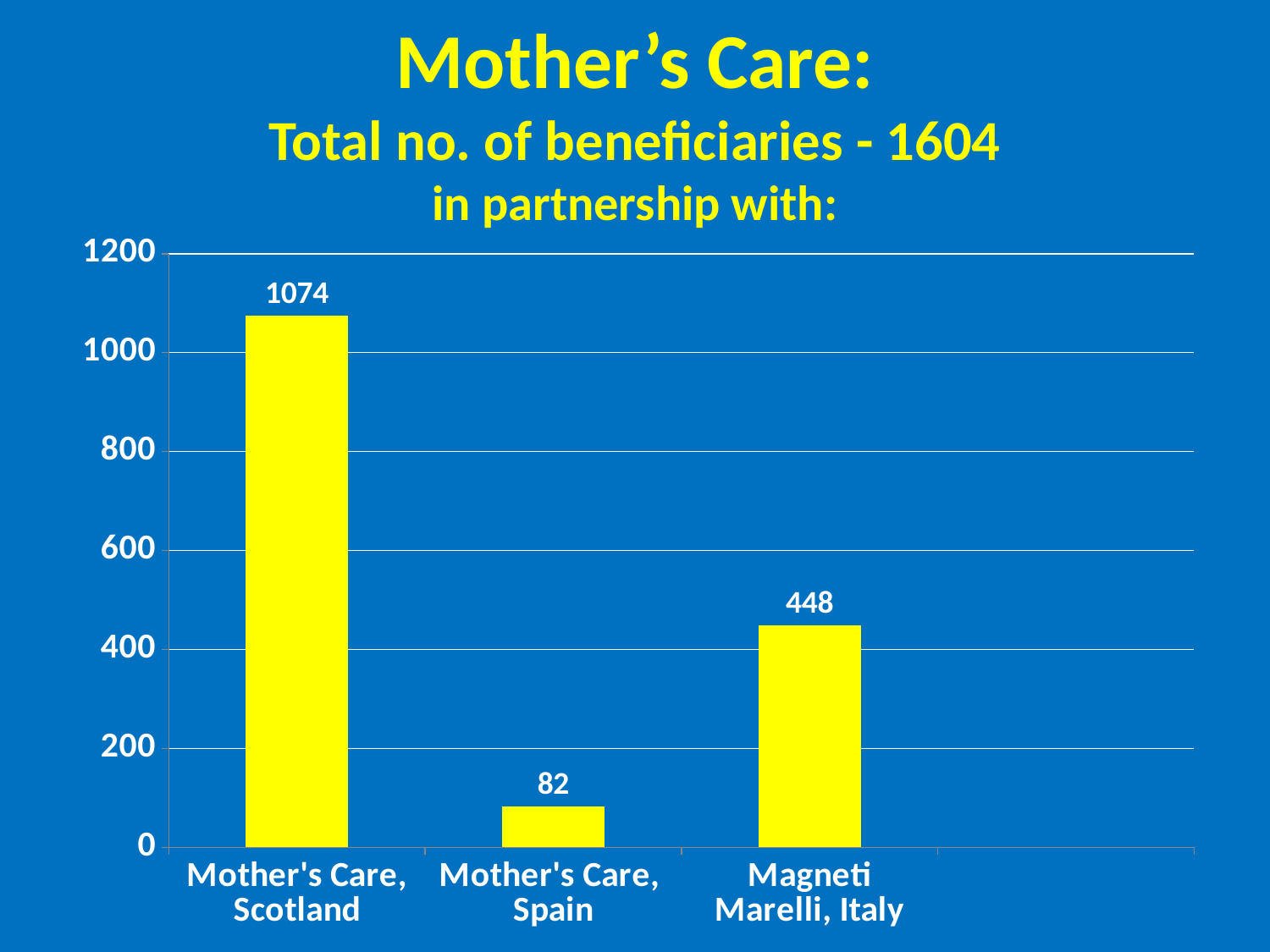
How many categories are shown on the chart? 3 What total number of beneficiaries is stated in the slide title? 1604 Is the value for Magneti Marelli, Italy greater or less than 600? less What is the difference between the values for Mother's Care, Scotland and Magneti Marelli, Italy? 626 Which category has the highest value? Mother's Care, Scotland What is the value for Mother's Care, Scotland? 1074 Which is larger, the value for Magneti Marelli, Italy or the value for Mother's Care, Spain? Magneti Marelli, Italy What is the value for Mother's Care, Spain? 82 What is the difference between the values for Magneti Marelli, Italy and Mother's Care, Spain? 366 Which category has the lowest value? Mother's Care, Spain What is the value for Magneti Marelli, Italy? 448 What kind of chart is shown on the slide? bar chart